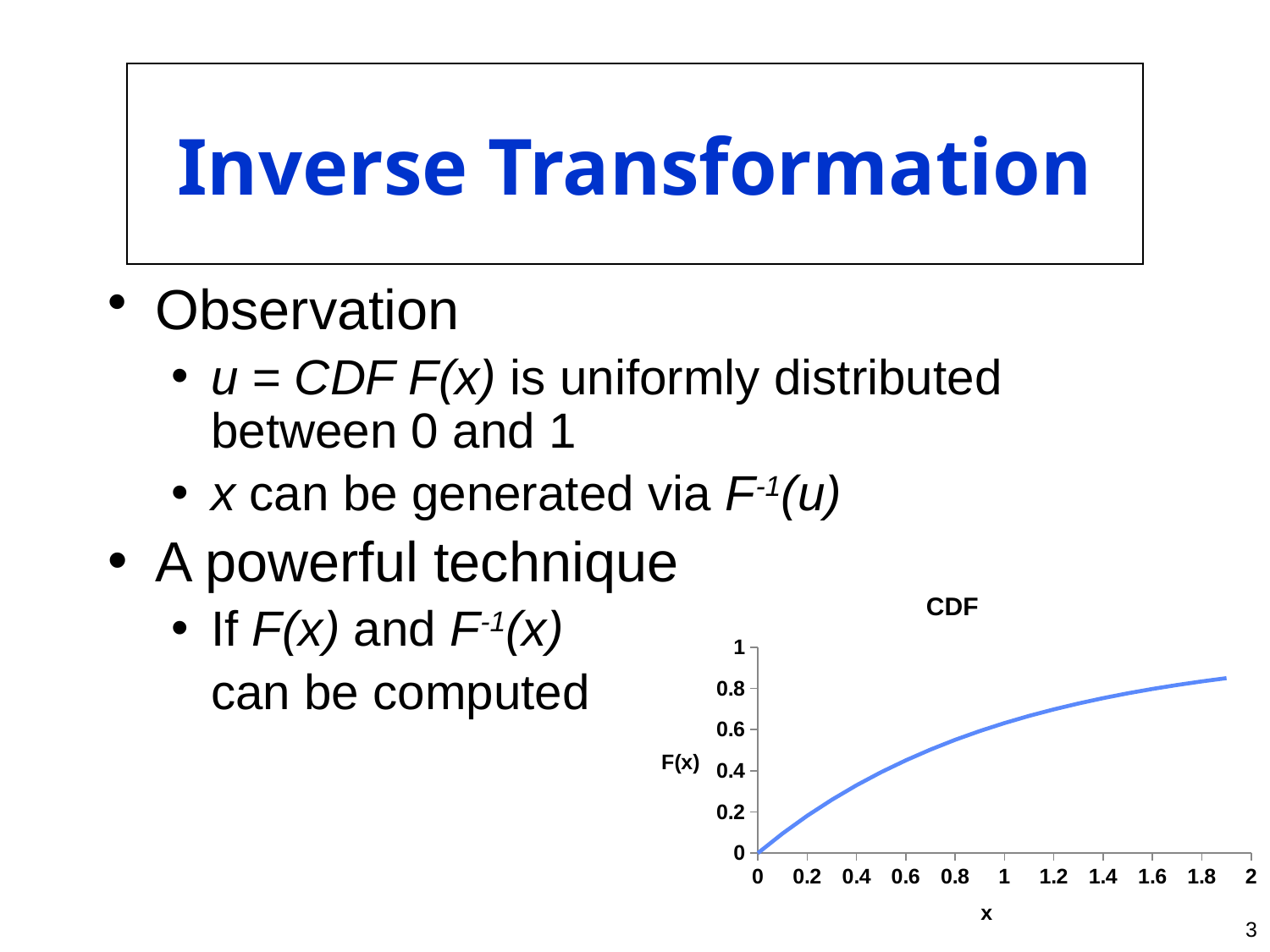
Does the plotted line rise or fall as x increases? rises What kind of chart is shown on the slide? line chart What is the title of the chart? CDF Is the value of F(x) at x = 1 greater or less than 0.4? greater Which is larger, F(x) at x = 0.6 or F(x) at x = 1.4? x = 1.4 Is the value of F(x) at x = 1.6 greater or less than 1? less What is the label of the vertical axis of the chart? F(x) Is the value of F(x) at x = 1.8 greater or less than 0.6? greater How many lines are plotted on the chart? 1 What is the value of F(x) at x = 0? 0